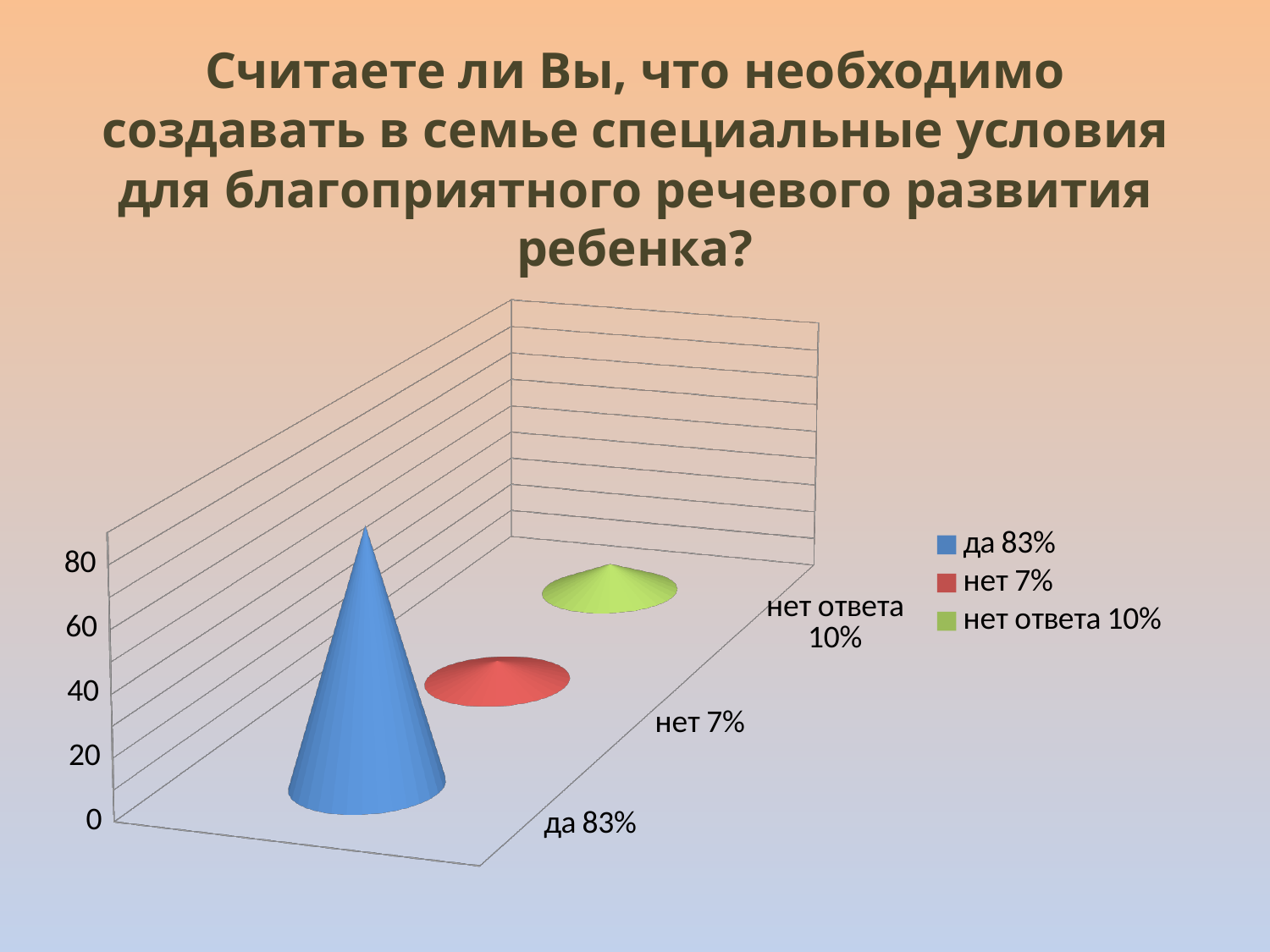
What percentage of respondents gave no answer ("нет ответа")? 10% Which is larger, the value for "нет ответа" or the value for "нет"? нет ответа What percentage of respondents answered "да"? 83% What colour represents the "да 83%" category in the legend? Blue How many answer categories are shown in the chart? 3 Which answer category has the lowest value? нет What percentage of respondents answered "нет"? 7% How many entries does the legend list? 3 Is the value for "да" greater or less than 60? greater What is the difference in percentage points between "да" and "нет"? 76 What is the difference in percentage points between "нет ответа" and "нет"? 3 Which answer category has the highest value? да